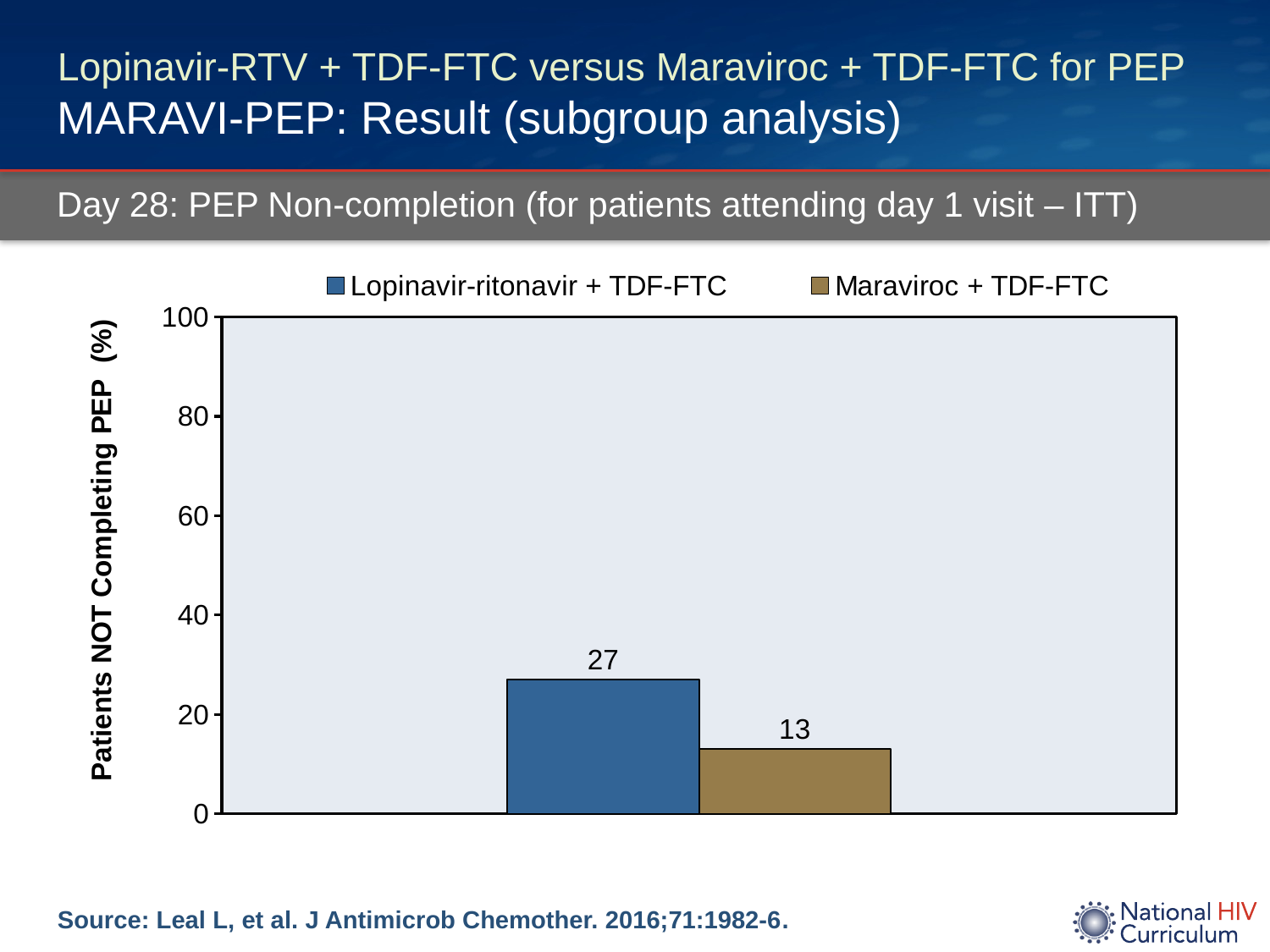
Which series has the higher percentage of patients not completing PEP? Lopinavir-ritonavir + TDF-FTC What is the difference between the Lopinavir-ritonavir + TDF-FTC value and the Maraviroc + TDF-FTC value? 14 Which series has the lower percentage of patients not completing PEP? Maraviroc + TDF-FTC What is the label of the y axis? Patients NOT Completing PEP (%) Is the value for Lopinavir-ritonavir + TDF-FTC larger or smaller than the value for Maraviroc + TDF-FTC? larger Is the value for Lopinavir-ritonavir + TDF-FTC greater or less than 20? greater What is the value for Maraviroc + TDF-FTC? 13 Is the value for Maraviroc + TDF-FTC greater or less than 20? less How many series does the legend list? 2 What is the value for Lopinavir-ritonavir + TDF-FTC? 27 How many bars are plotted on the chart? 2 What kind of chart is shown on the slide? bar chart